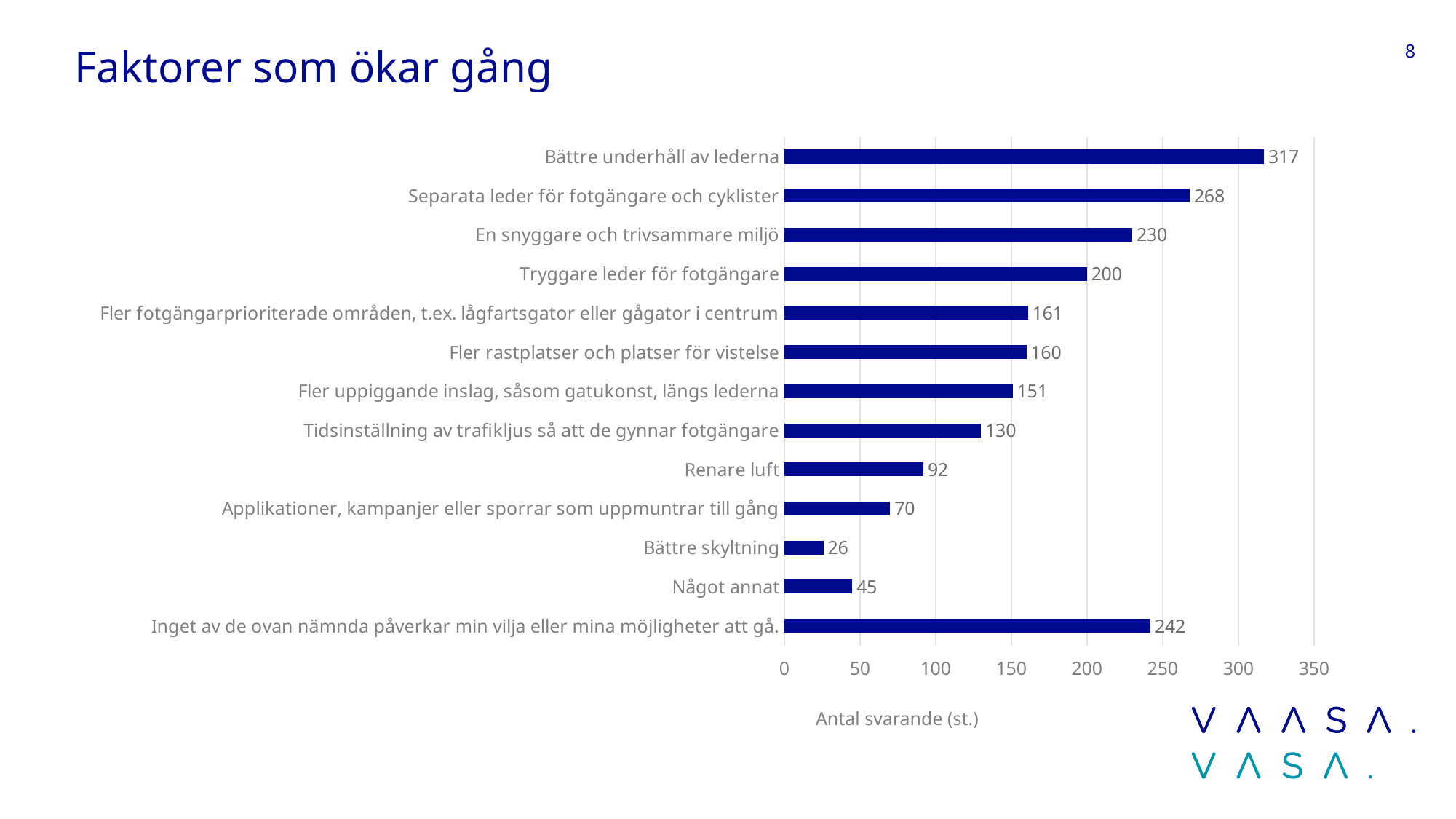
What is the title of the slide? Faktorer som ökar gång What is the value for "Bättre underhåll av lederna"? 317 Which is larger: "Tryggare leder för fotgängare" or "Inget av de ovan nämnda påverkar min vilja eller mina möjligheter att gå."? Inget av de ovan nämnda påverkar min vilja eller mina möjligheter att gå. Is the value for "Tidsinställning av trafikljus så att de gynnar fotgängare" greater or less than 150? less Which category has the highest value? Bättre underhåll av lederna What is the value for "Renare luft"? 92 What is the label of the horizontal axis? Antal svarande (st.) Which category has the lowest value? Bättre skyltning What kind of chart is shown on the slide? bar chart How many categories are shown in the chart? 13 What is the difference between "Separata leder för fotgängare och cyklister" and "En snyggare och trivsammare miljö"? 38 What is the value for "Inget av de ovan nämnda påverkar min vilja eller mina möjligheter att gå."? 242